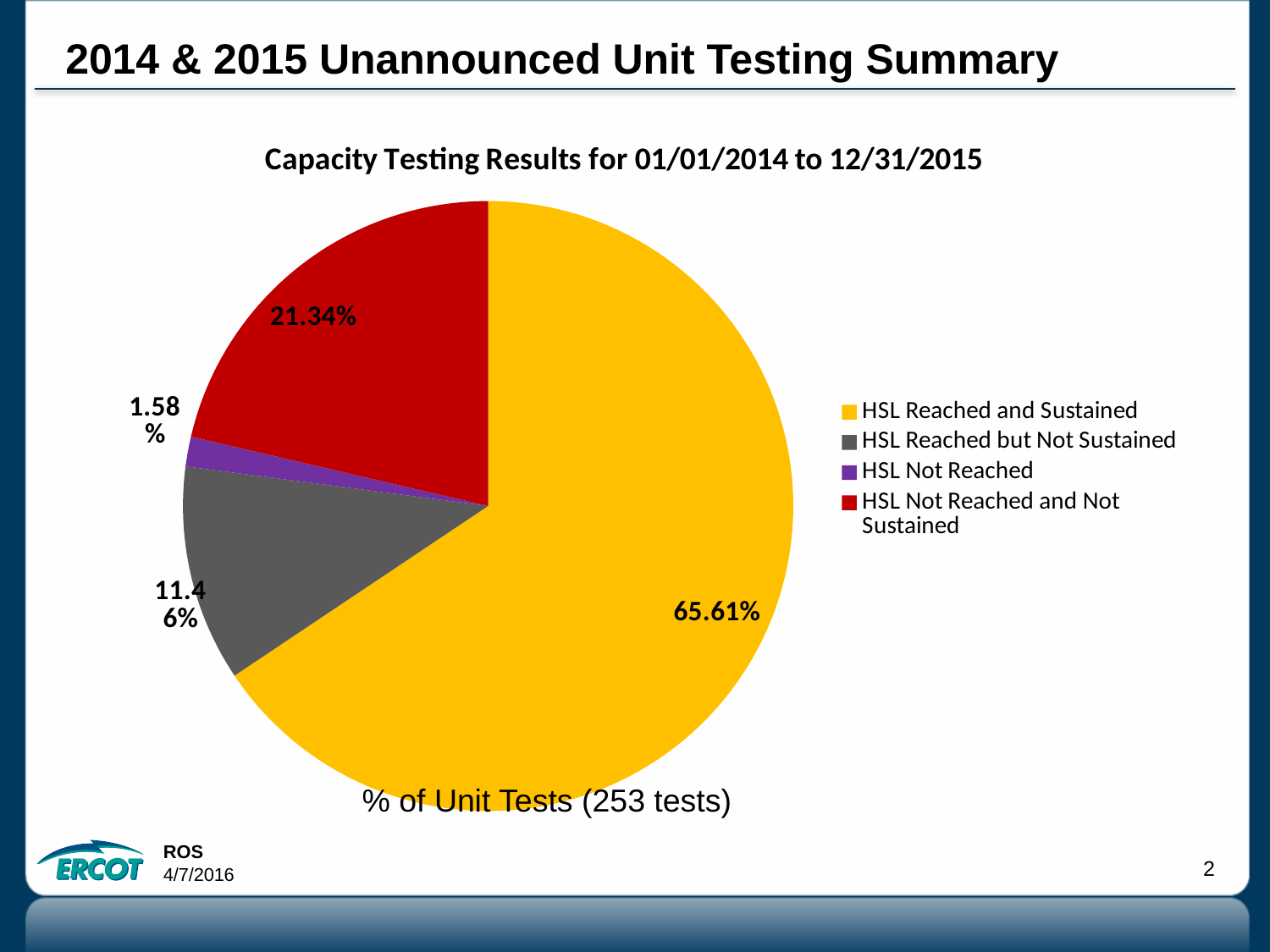
What percentage of unit tests resulted in HSL Not Reached and Not Sustained? 21.34% How many unit tests does the chart represent, according to the label below the pie? 253 tests What percentage of unit tests resulted in HSL Reached and Sustained? 65.61% Which category has the smallest share of the pie? HSL Not Reached What is the difference in percentage points between HSL Not Reached and Not Sustained and HSL Reached but Not Sustained? 9.88 How many categories does the legend list? 4 Which is larger: the share for HSL Reached but Not Sustained or the share for HSL Not Reached and Not Sustained? HSL Not Reached and Not Sustained What is the title of the chart? Capacity Testing Results for 01/01/2014 to 12/31/2015 Which category has the largest share of the pie? HSL Reached and Sustained What percentage of unit tests resulted in HSL Not Reached? 1.58% What percentage of unit tests resulted in HSL Reached but Not Sustained? 11.46% What kind of chart is shown on the slide? Pie chart